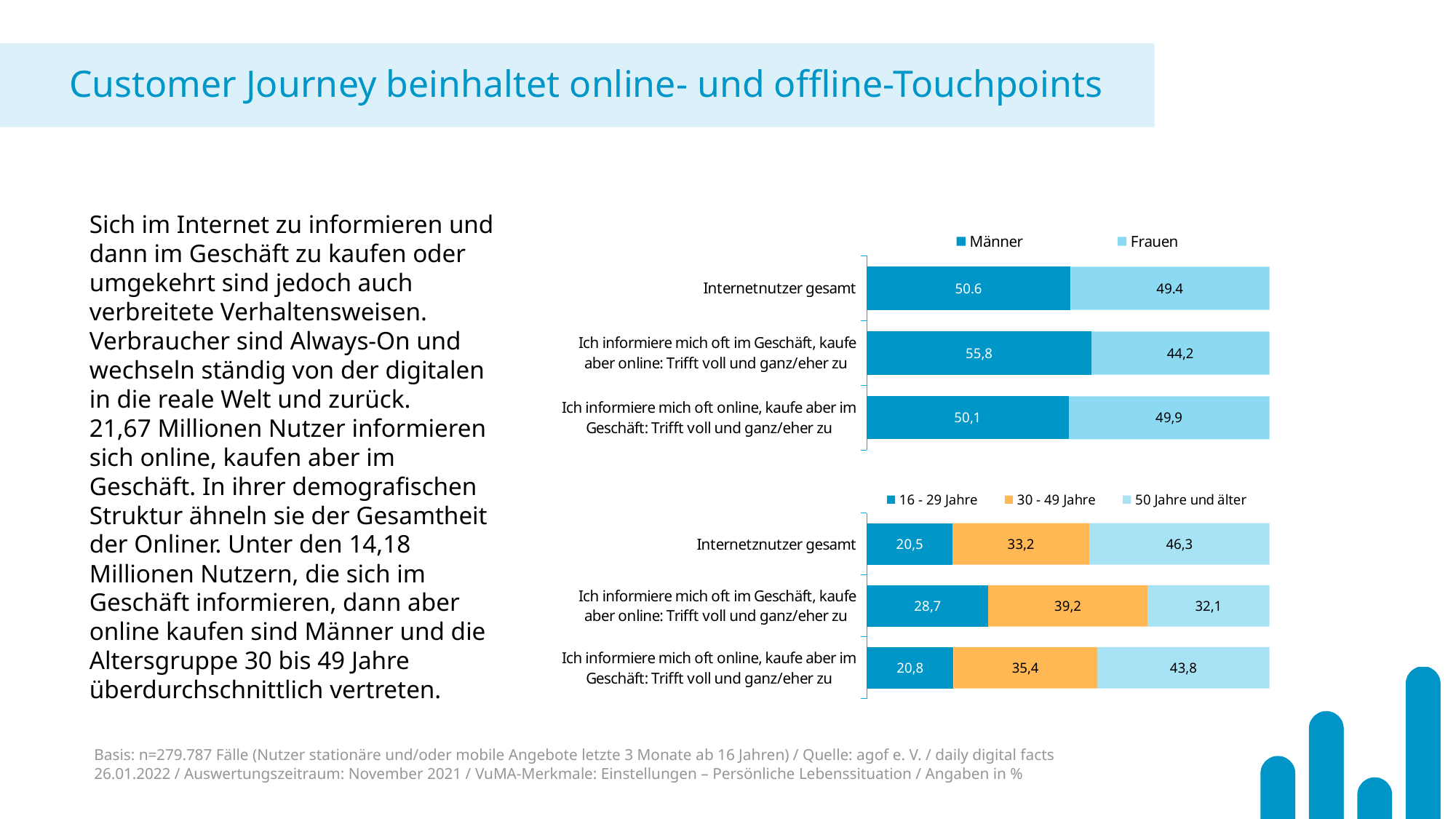
What kind of chart is the bottom chart (age groups)? Stacked bar chart In the bottom chart (age groups), is the 50 Jahre und älter value larger for Internetznutzer gesamt or for 'Ich informiere mich oft online, kaufe aber im Geschäft'? Internetznutzer gesamt In the bottom chart (age groups), how many series does the legend list? 3 In the top chart (Männer/Frauen), how many series does the legend list? 2 In the top chart (Männer/Frauen), what is the difference between the Männer and Frauen values for 'Ich informiere mich oft im Geschäft, kaufe aber online'? 11,6 In the top chart (Männer/Frauen), what is the value for Frauen for 'Ich informiere mich oft im Geschäft, kaufe aber online'? 44,2 In the bottom chart (age groups), what is the value for 30 - 49 Jahre for 'Ich informiere mich oft im Geschäft, kaufe aber online'? 39,2 In the bottom chart (age groups), which category has the lowest value for 16 - 29 Jahre? Internetznutzer gesamt In the bottom chart (age groups), what is the value for 50 Jahre und älter for Internetznutzer gesamt? 46,3 In the top chart (Männer/Frauen), what is the value for Männer for Internetnutzer gesamt? 50.6 In the top chart (Männer/Frauen), which category has the highest Männer value? Ich informiere mich oft im Geschäft, kaufe aber online: Trifft voll und ganz/eher zu In the bottom chart (age groups), how many categories are shown? 3